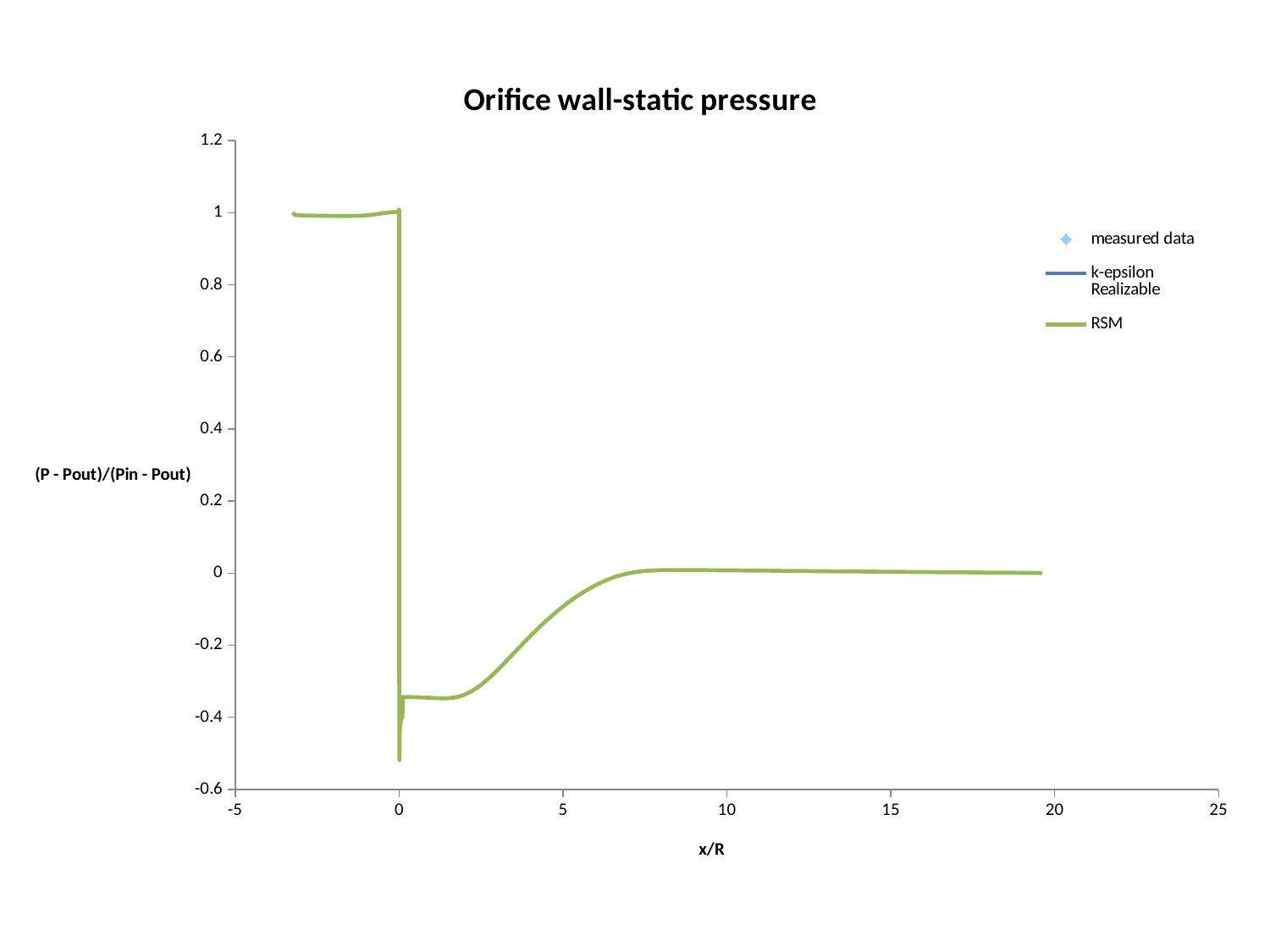
Near which x/R tick does the curve reach its lowest value? 0 What kind of chart is shown on the slide? line chart What is the label of the x axis? x/R Is the plotted value at x/R = -3 greater or less than 0.8? greater Is the plotted value at x/R = -3 larger or smaller than the value at x/R = 1? larger What is the highest value shown on the y axis? 1.2 Is the plotted value at x/R = 10 greater or less than 0.2? less What is the title of the chart? Orifice wall-static pressure How many series does the legend list? 3 Is the plotted value at x/R = 1 greater or less than -0.2? less Between x/R = 2 and x/R = 7, does the plotted curve rise or fall? rise